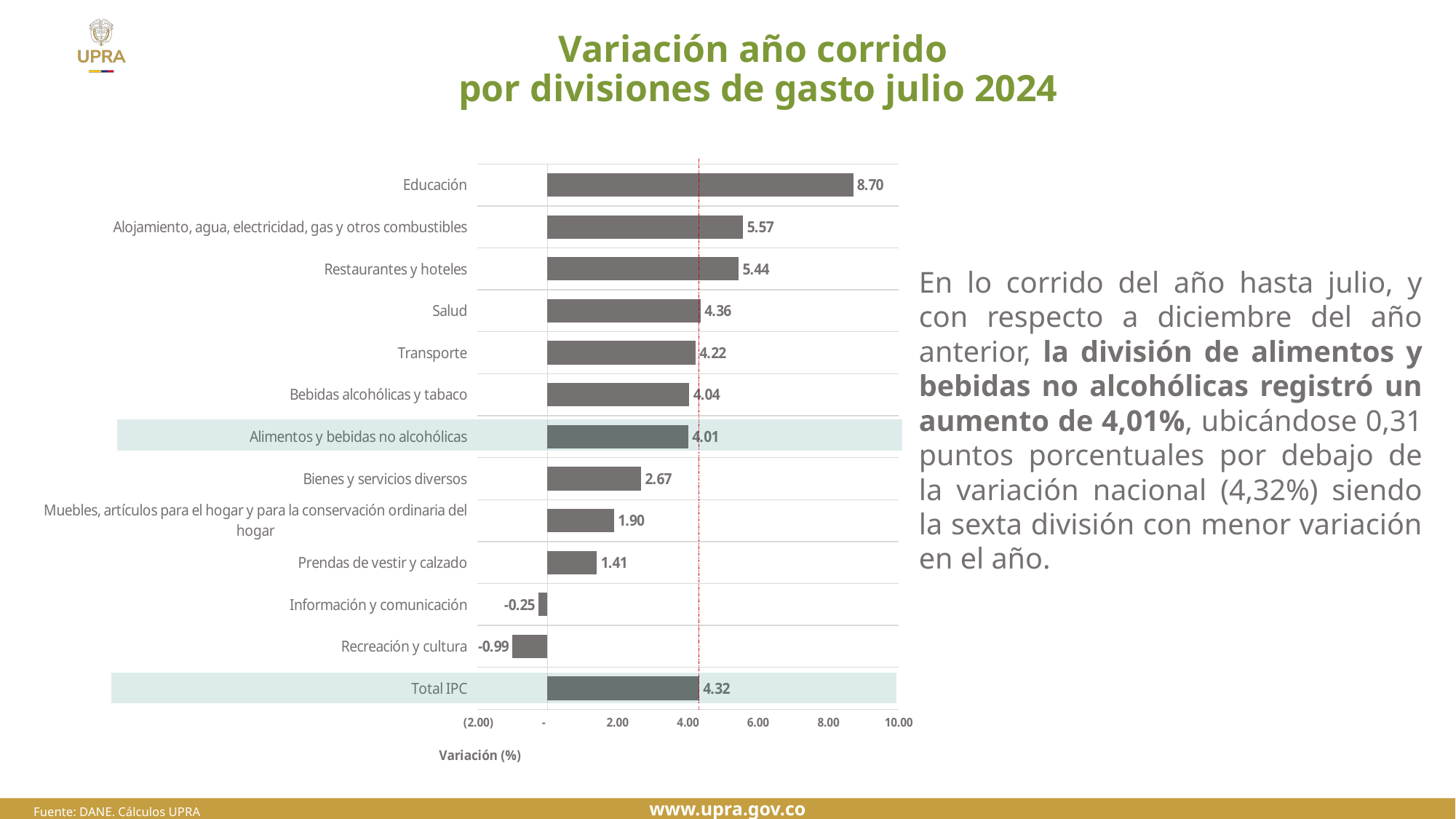
Is the value for Restaurantes y hoteles greater or less than 4.00? greater What is the value for Total IPC? 4.32 What is the value for Recreación y cultura? -0.99 What is the difference between the values for Educación and Salud? 4.34 Which category has the lowest value? Recreación y cultura Which is larger, the value for Transporte or the value for Bienes y servicios diversos? Transporte Which category has the highest value? Educación What kind of chart is shown on the slide? Bar chart What is the value for Alimentos y bebidas no alcohólicas? 4.01 What is the value for Educación? 8.70 How many bars are plotted in the chart? 13 What is the label of the horizontal axis? Variación (%)